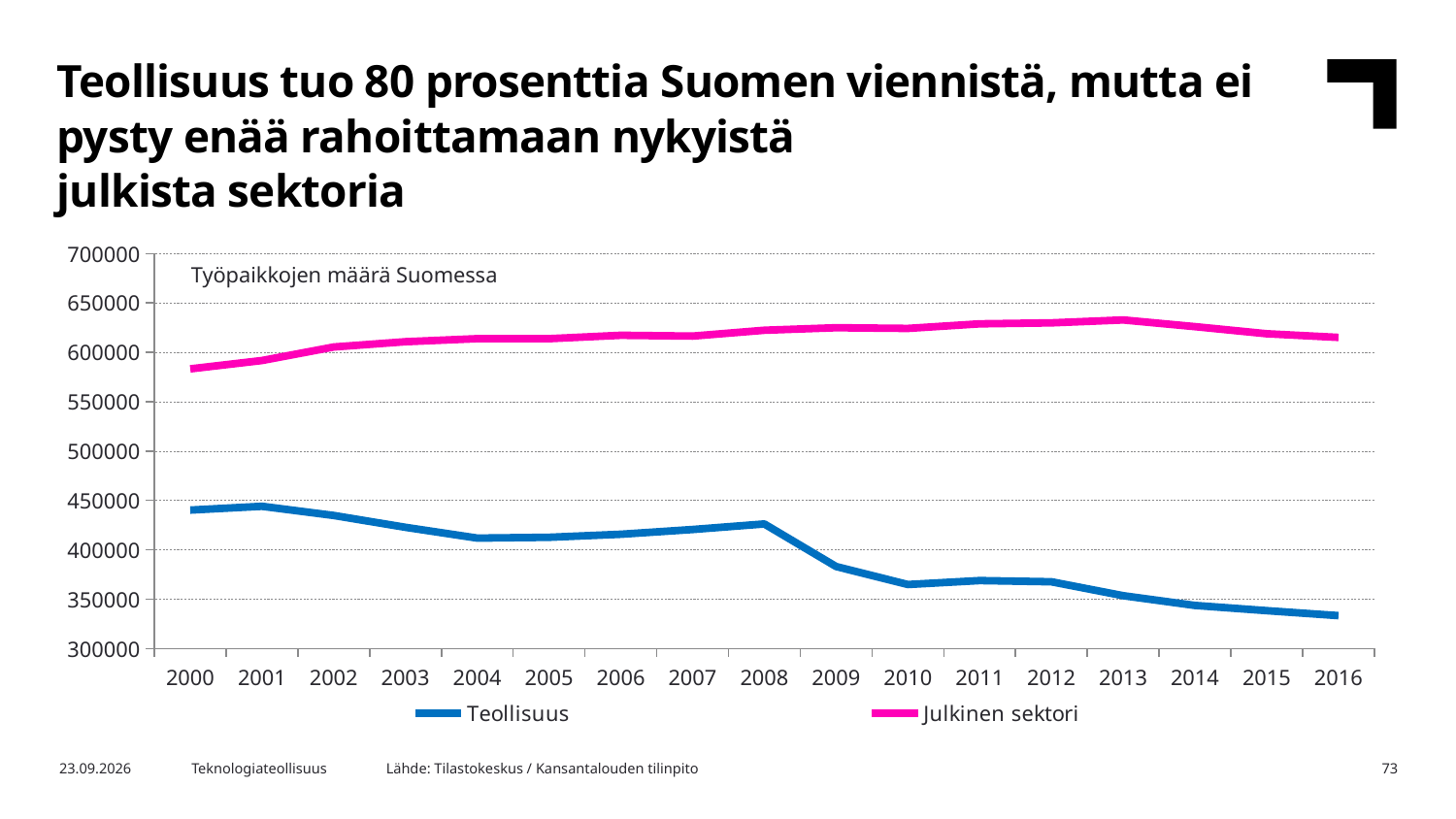
How many years are plotted along the x axis? 17 Does the Teollisuus line rise or fall overall from 2000 to 2016? fall In which year is the Teollisuus value lowest? 2016 Is the Teollisuus value for 2016 greater or less than 350000? less What is the title printed inside the chart area? Työpaikkojen määrä Suomessa In which year is the Julkinen sektori value lowest? 2000 What kind of chart is shown on the slide? line chart Which series is drawn in pink? Julkinen sektori In 2016, which series has the larger value, Teollisuus or Julkinen sektori? Julkinen sektori How many series does the legend list? 2 Does the Julkinen sektori line rise or fall overall from 2000 to 2016? rise Is the Julkinen sektori value for 2013 greater or less than 600000? greater